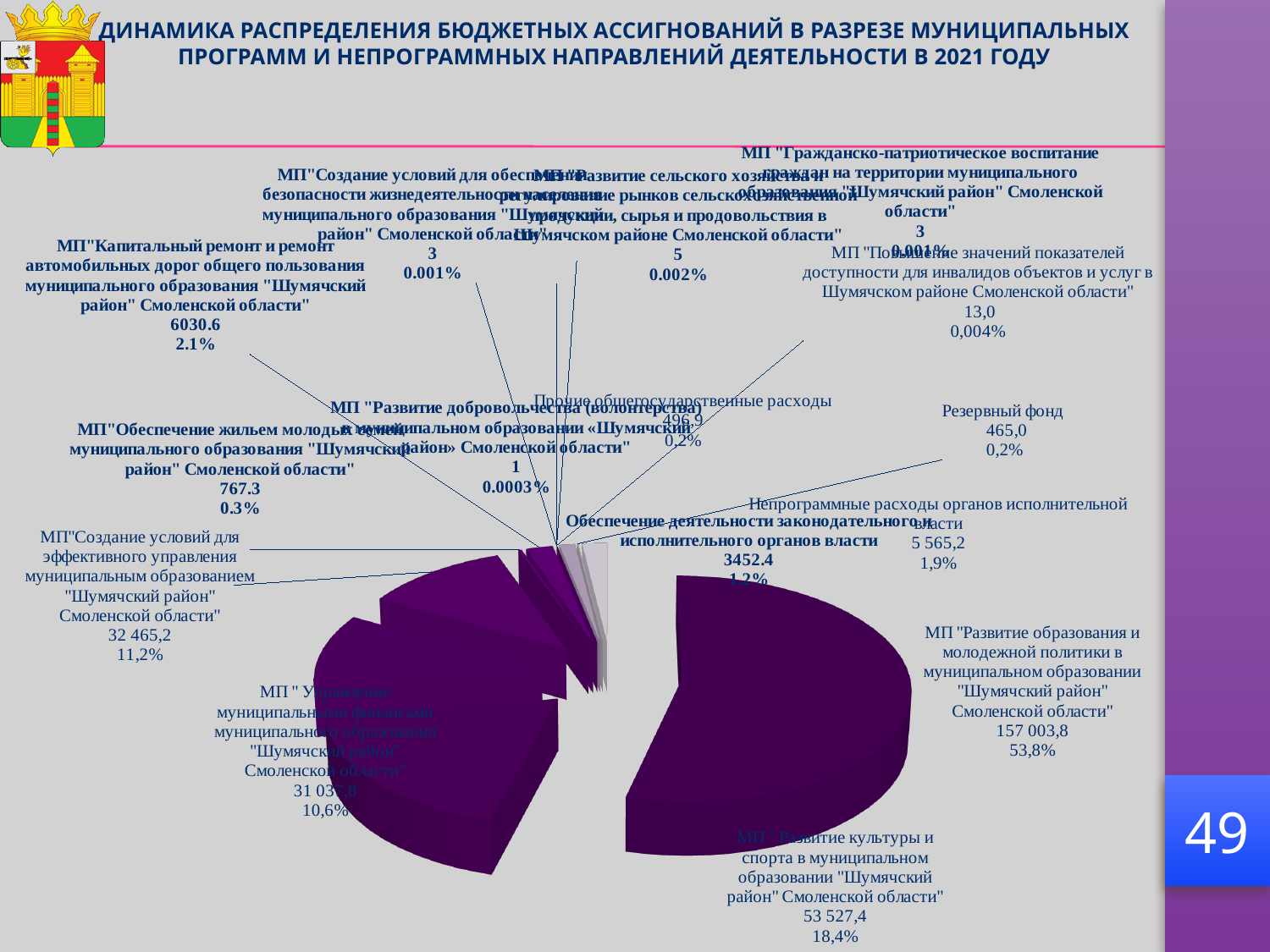
Which category has the smallest share of the pie? МП "Развитие добровольчества (волонтерства) в муниципальном образовании «Шумячский район» Смоленской области" What share of the pie does МП "Развитие образования и молодежной политики" account for? 53,8% What share of the pie does МП "Капитальный ремонт и ремонт автомобильных дорог общего пользования" account for? 2.1% What value is shown for МП "Создание условий для эффективного управления муниципальным образованием "Шумячский район" Смоленской области"? 32 465,2 What value is shown for МП "Развитие культуры и спорта в муниципальном образовании "Шумячский район" Смоленской области"? 53 527,4 Which category has the largest share of the pie? МП "Развитие образования и молодежной политики в муниципальном образовании "Шумячский район" Смоленской области" Which is larger: the value for МП "Создание условий для эффективного управления" (32 465,2) or the value for МП "Управление муниципальными финансами" (31 037,8)? МП "Создание условий для эффективного управления муниципальным образованием "Шумячский район" Смоленской области" What value is shown for Непрограммные расходы органов исполнительной власти? 5 565,2 What value is shown for Резервный фонд? 465,0 What kind of chart is shown on the slide? pie chart What is the difference between the value for МП "Развитие образования и молодежной политики" (157 003,8) and the value for МП "Развитие культуры и спорта" (53 527,4)? 103 476,4 What share of the pie does МП "Развитие культуры и спорта" account for? 18,4%